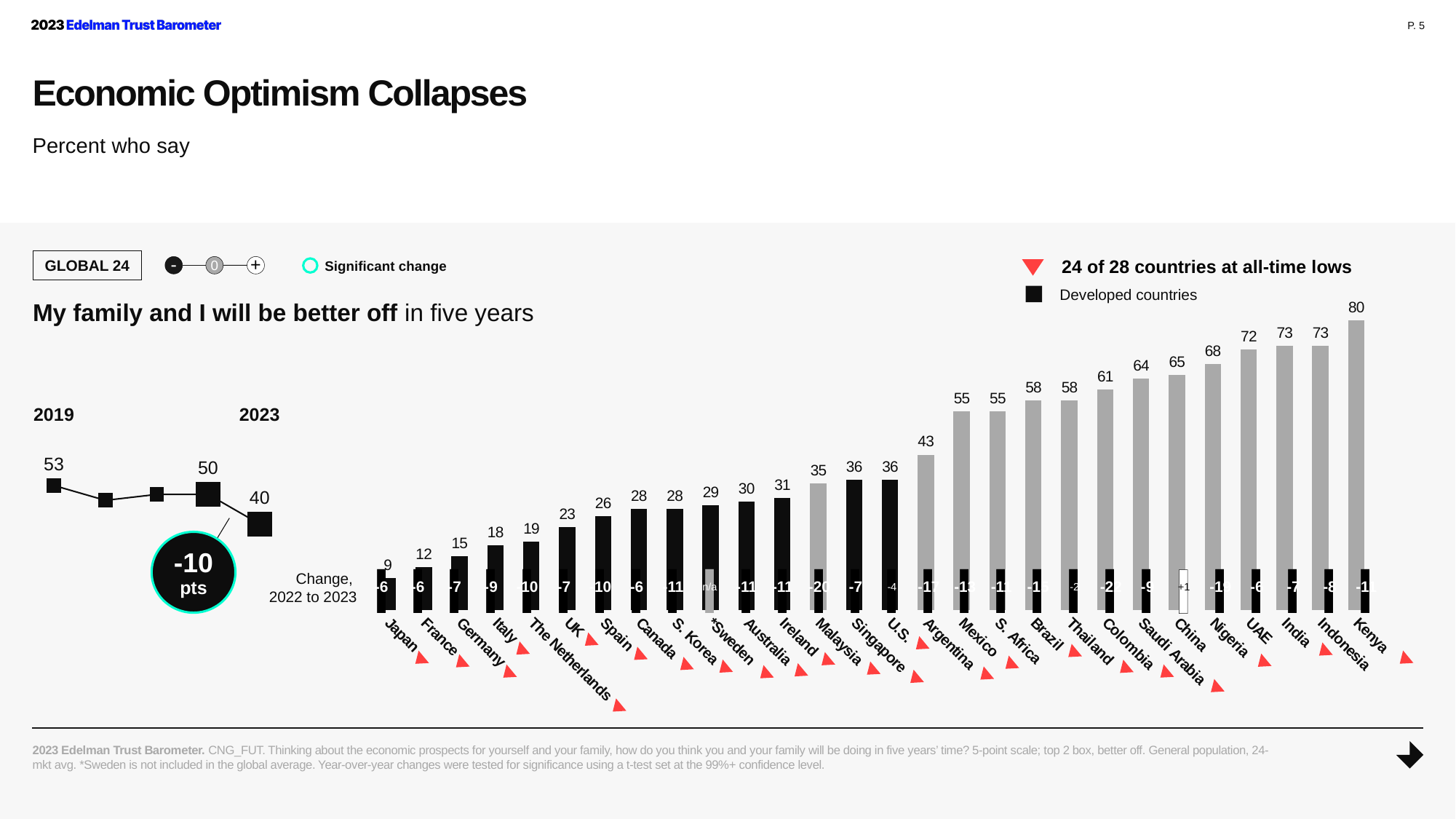
In the bar chart, which country has the lowest value? Japan How many countries are shown in the bar chart? 28 In the bar chart, which country has the highest value? Kenya In the bar chart, what is the value shown for the U.S.? 36 In the Global 24 line chart on the left, what is the change in points highlighted in the circle? -10 pts In the bar chart, what is the value shown for Japan? 9 In the bar chart, which has a higher value, Argentina or Mexico? Mexico In the bar chart, what percent of respondents in Kenya say their family will be better off in five years? 80 According to the legend, what do the black bars in the bar chart represent? Developed countries In the Global 24 line chart on the left, what was the value in 2019? 53 In the bar chart, what is the difference between the values for Kenya and Japan? 71 In the Global 24 line chart on the left, what was the value in 2023? 40